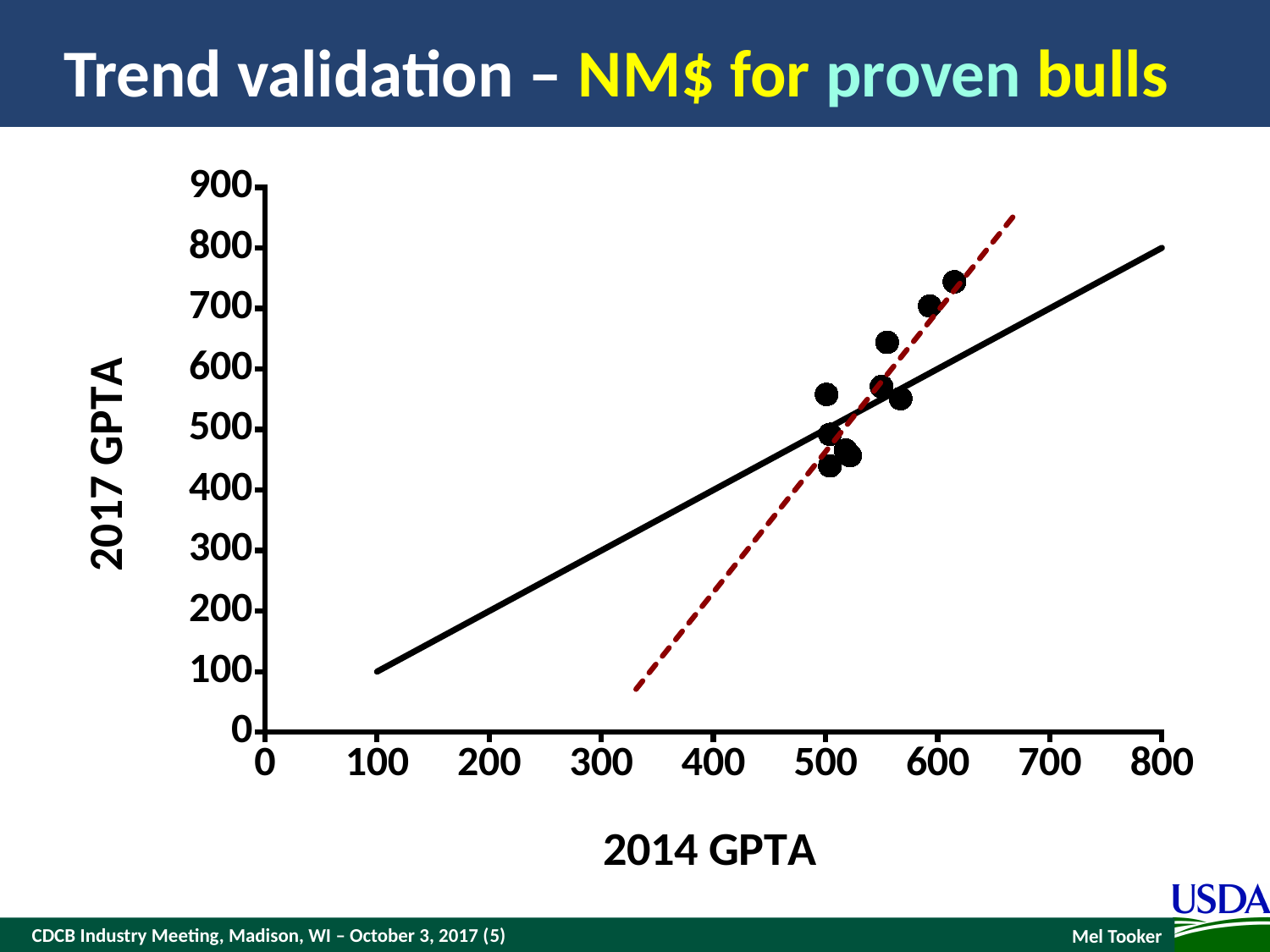
Is the 2014 GPTA of the rightmost plotted point greater or less than 700? less What is the title of the x axis? 2014 GPTA Is the 2017 GPTA of the highest plotted point greater or less than 700? greater What is the highest tick value shown on the x axis? 800 Is the 2014 GPTA of every plotted point greater or less than 400? greater Do the plotted points generally rise or fall as the 2014 GPTA increases? rise At what 2017 GPTA value does the solid black line end at the right edge of the chart (x = 800)? 800 What is the title of the y axis? 2017 GPTA What is the spacing between consecutive tick labels on the y axis? 100 What kind of chart is shown on the slide? scatter chart What is the highest tick value shown on the y axis? 900